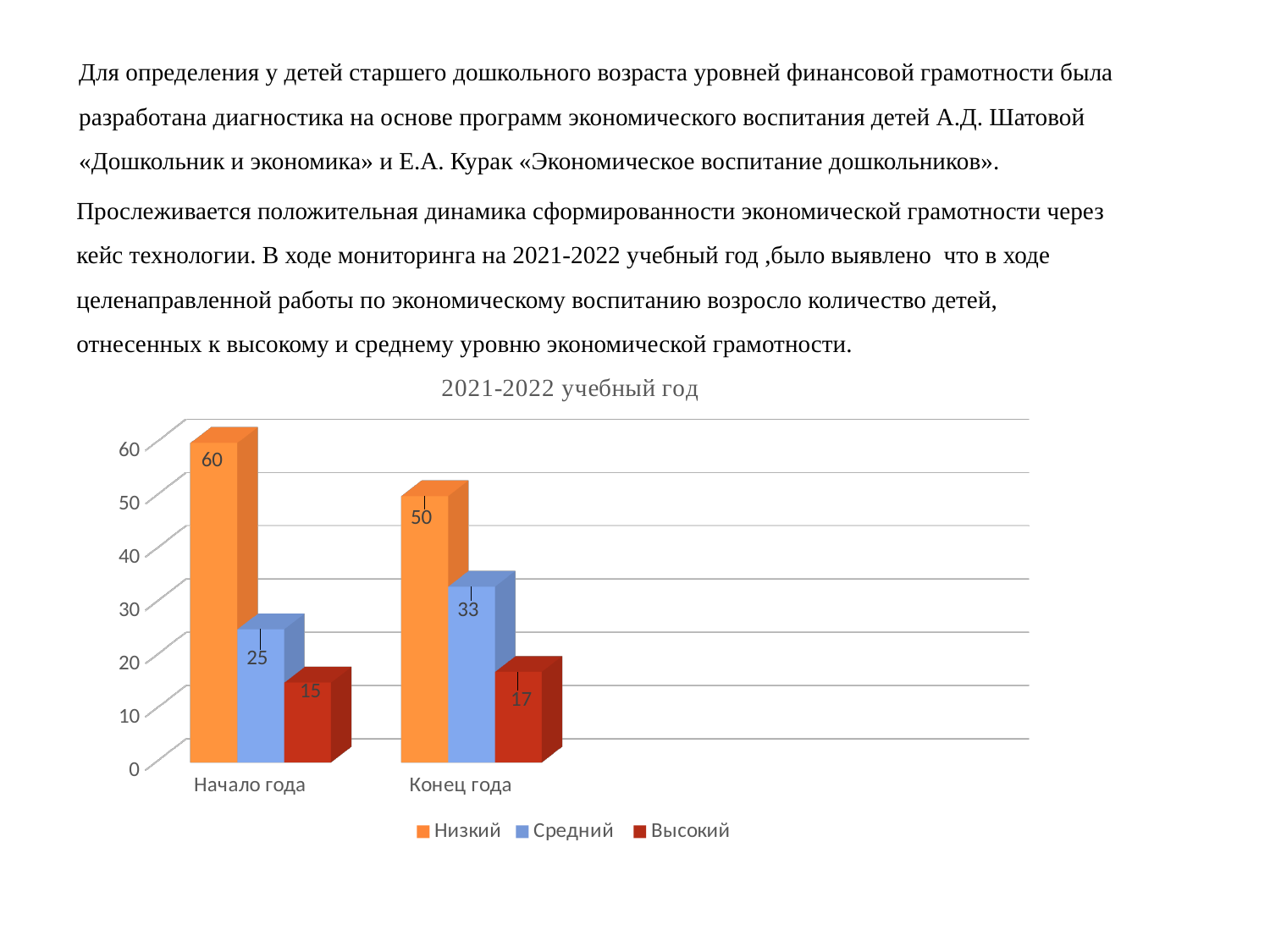
What is the value for Низкий at Конец года? 50 What is the title of the chart? 2021-2022 учебный год Which series has the highest value at Начало года? Низкий Which is larger: Средний at Начало года or Средний at Конец года? Средний at Конец года What is the value for Низкий at Начало года? 60 How many series does the legend list? 3 Which series has the lowest value at Конец года? Высокий What is the value for Высокий at Начало года? 15 What is the difference between the Низкий values at Начало года and Конец года? 10 How many categories are shown on the x axis? 2 What is the value for Средний at Конец года? 33 What kind of chart is shown on the slide? Bar chart